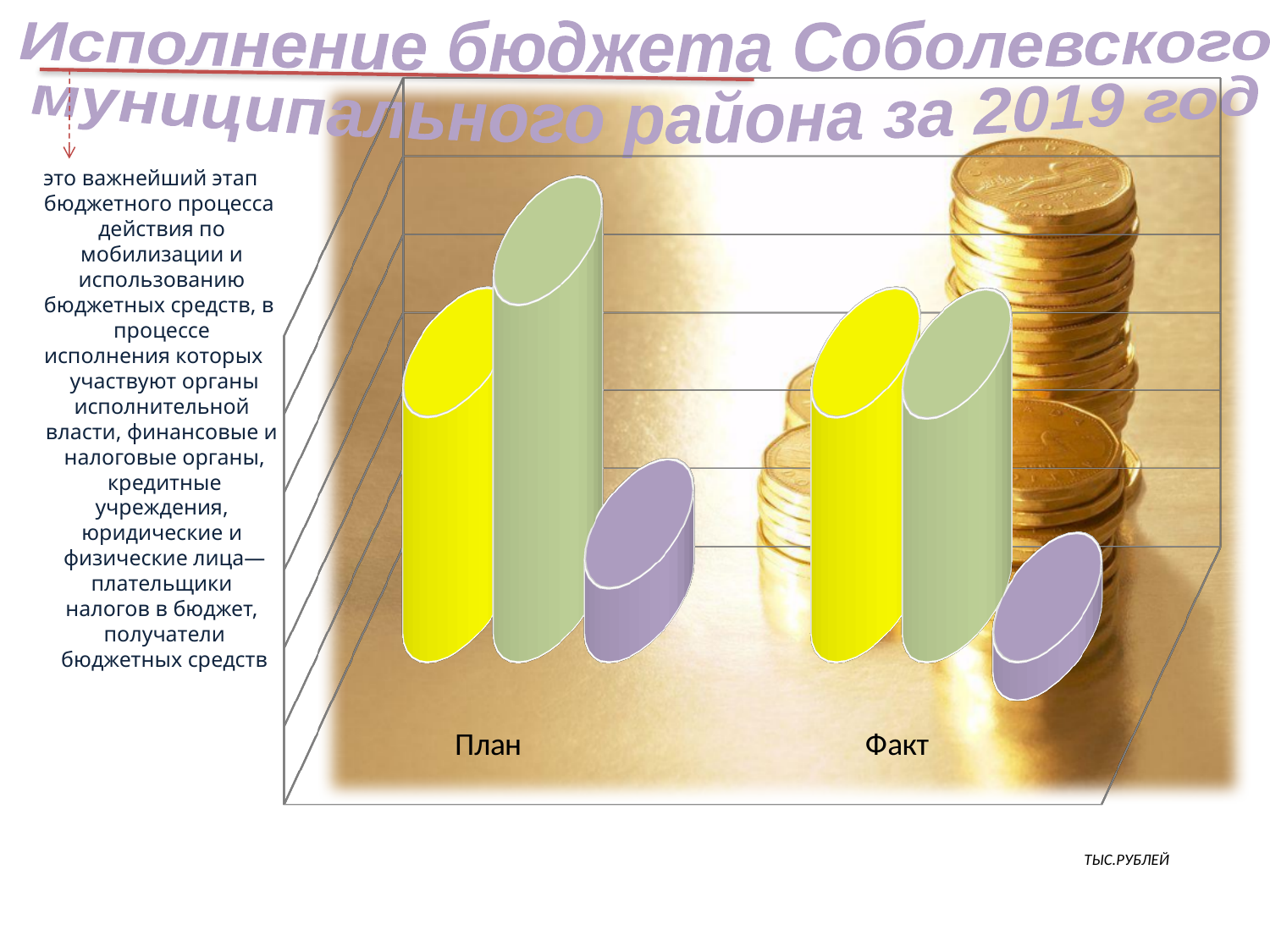
Within the category План, which coloured bar is the tallest? green Which category has the taller green bar, План or Факт? План Which category has the taller purple bar, План or Факт? План Within the category План, which coloured bar is the shortest? purple Does the green bar rise or fall from План to Факт? fall What unit is indicated below the chart? ТЫС.РУБЛЕЙ What kind of chart is shown on the slide? bar chart How many categories are shown on the x axis of the chart? 2 What are the two category labels on the x axis of the chart? План and Факт How many bars are plotted for the category План? 3 Within the category Факт, which coloured bar is the shortest? purple